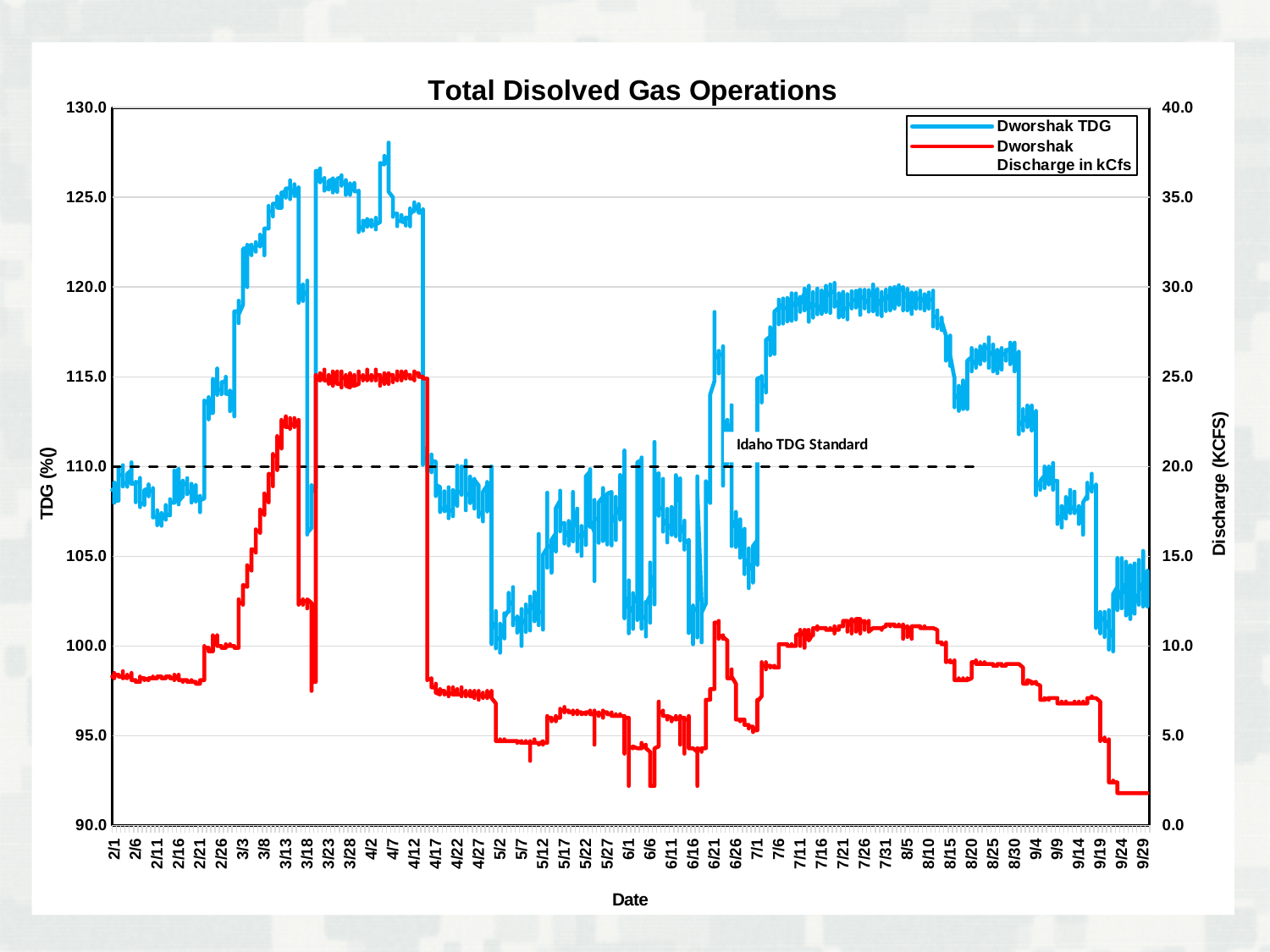
Does the Dworshak TDG line rise or fall between 2/1 and 3/13? rise Is the Dworshak TDG value around 4/7 greater or less than 125? greater Is the Dworshak TDG value around 5/2 greater or less than 105? less Which is larger, the Dworshak Discharge around 3/28 or around 9/29? around 3/28 What is the title of the chart? Total Disolved Gas Operations What kind of chart is shown on the slide? line chart At what TDG (%) value is the Idaho TDG Standard dashed line drawn? 110.0 Is the Dworshak TDG value around 7/21 greater or less than 115? greater What is the label of the right-hand vertical axis? Discharge (KCFS) How many series does the legend list? 2